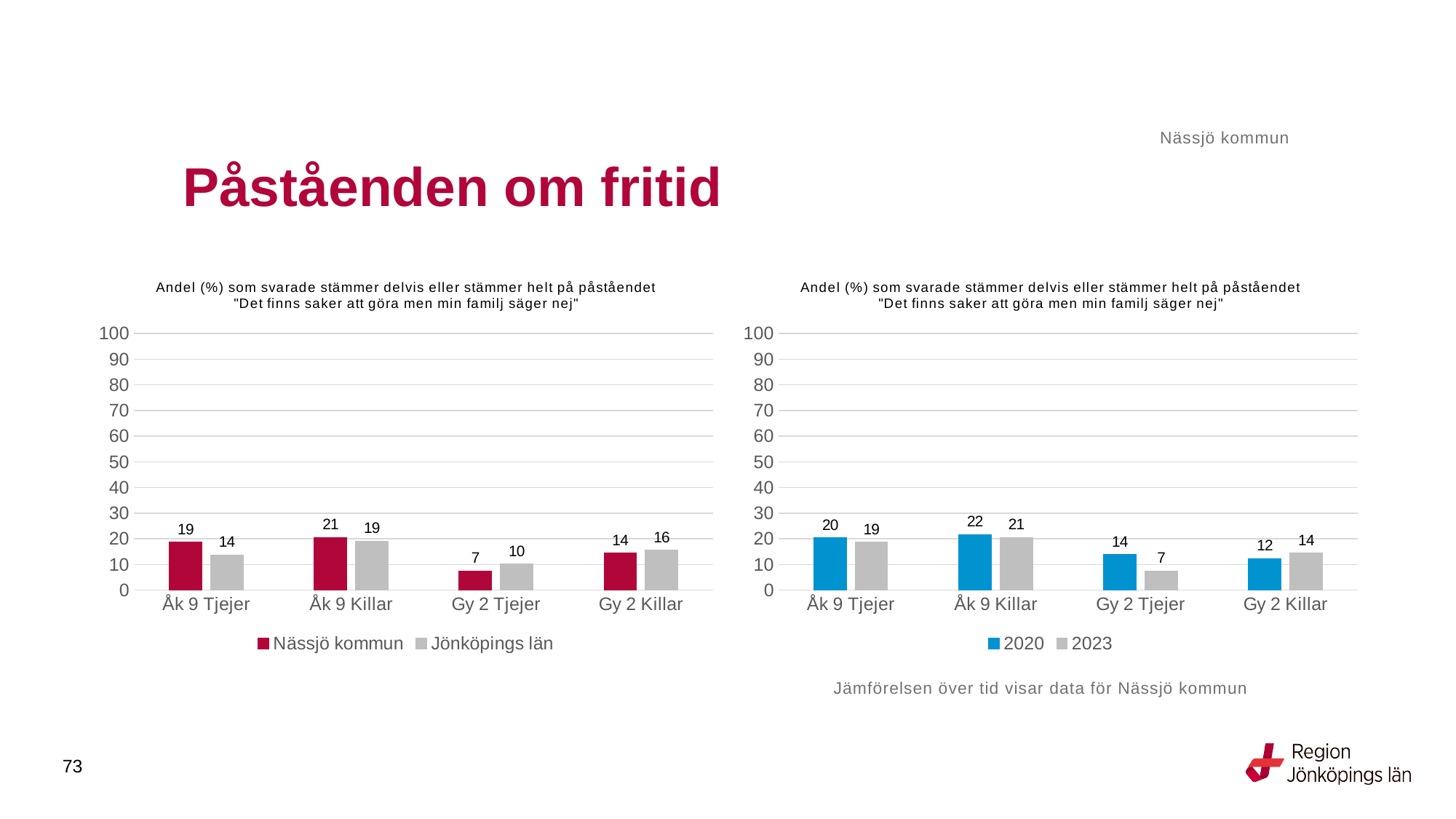
In the left chart, how many series does the legend list? 2 In the right chart, what is the difference between 2020 and 2023 for Gy 2 Tjejer? 7 In the left chart, which is larger for Gy 2 Killar: Nässjö kommun or Jönköpings län? Jönköpings län In the right chart, which category has the highest value for 2020? Åk 9 Killar How many categories are shown on the x axis of the right chart? 4 In the right chart, what is the value for 2023 for Gy 2 Killar? 14 In the left chart, which category has the lowest value for Nässjö kommun? Gy 2 Tjejer In the right chart, what is the value for 2020 for Gy 2 Tjejer? 14 In the left chart, what is the value for Jönköpings län for Gy 2 Tjejer? 10 In the left chart, what is the difference between Nässjö kommun and Jönköpings län for Åk 9 Tjejer? 5 In the left chart, what is the value for Nässjö kommun for Åk 9 Killar? 21 What kind of chart is the left chart? Bar chart